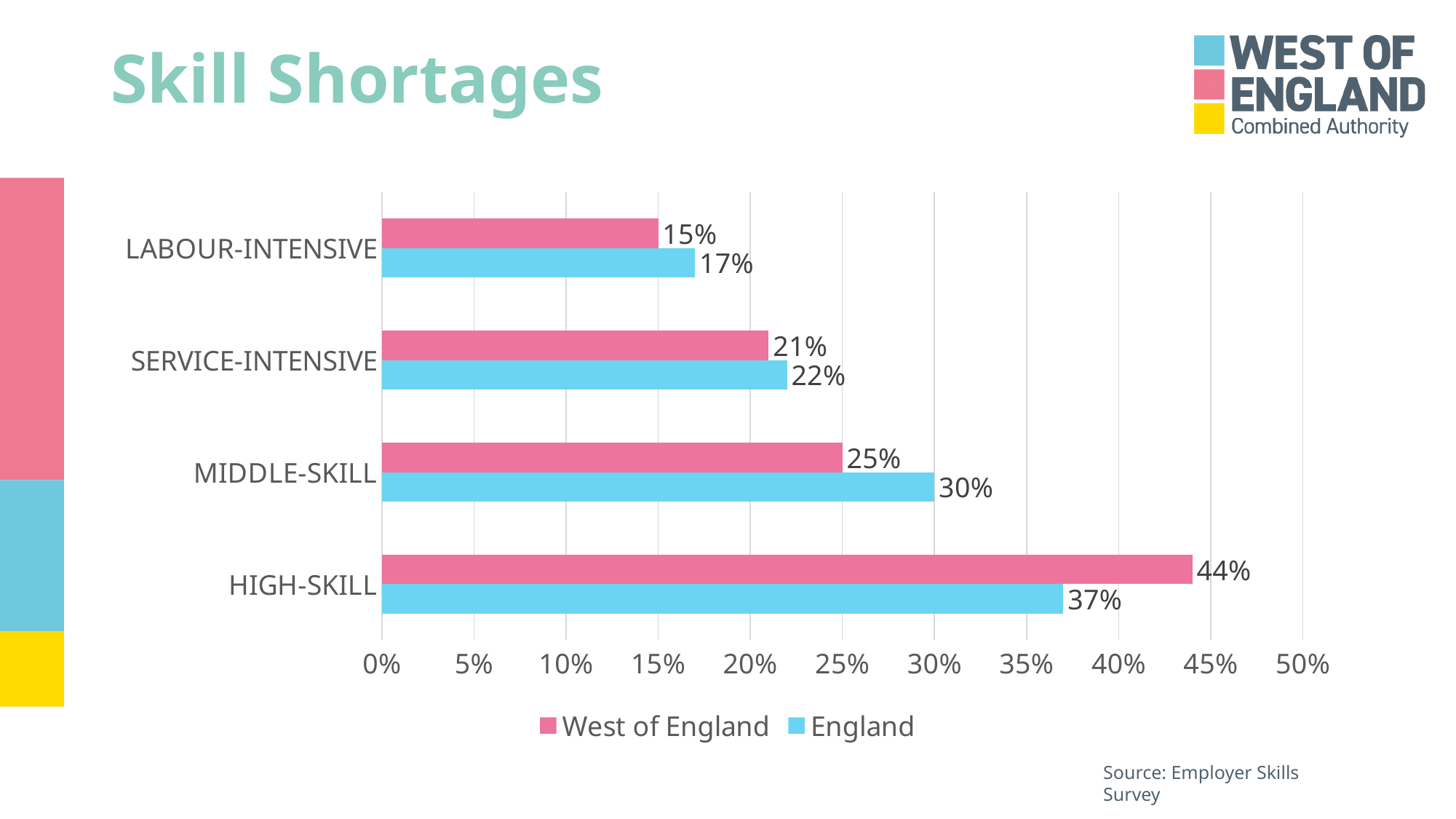
What is the England value for MIDDLE-SKILL? 30% Which category has the highest West of England value? HIGH-SKILL For SERVICE-INTENSIVE, which series has the larger value, West of England or England? England What is the West of England value for HIGH-SKILL? 44% How many series does the legend list? 2 How many categories are shown on the chart? 4 What is the difference between the West of England and England values for HIGH-SKILL? 7% What is the England value for SERVICE-INTENSIVE? 22% What kind of chart is shown on the slide? Bar chart Which category has the lowest England value? LABOUR-INTENSIVE What is the difference between the England and West of England values for MIDDLE-SKILL? 5% What is the West of England value for LABOUR-INTENSIVE? 15%